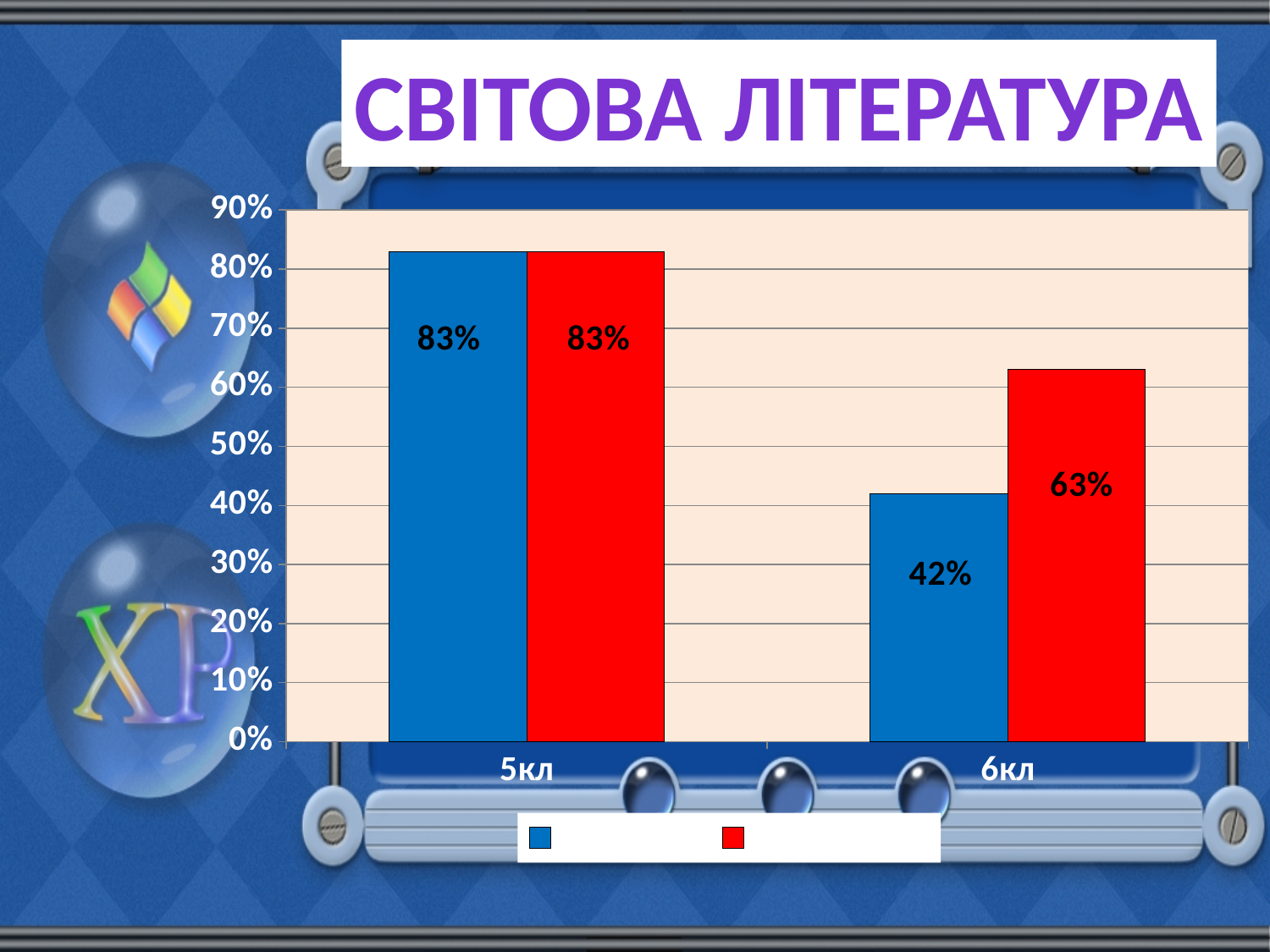
Is the value of the blue bar for 6кл greater or less than 50%? less What is the title of the chart? СВІТОВА ЛІТЕРАТУРА Which category has the lowest blue bar? 6кл What is the value of the red bar for 5кл? 83% What is the difference between the red and blue bars for 6кл? 21% What is the difference between the blue bar for 5кл and the blue bar for 6кл? 41% What kind of chart is shown on the slide? bar chart What is the value of the blue bar for 6кл? 42% What is the value of the blue bar for 5кл? 83% How many categories are shown on the x axis? 2 What is the value of the red bar for 6кл? 63% For 6кл, which bar is larger, the blue or the red? red